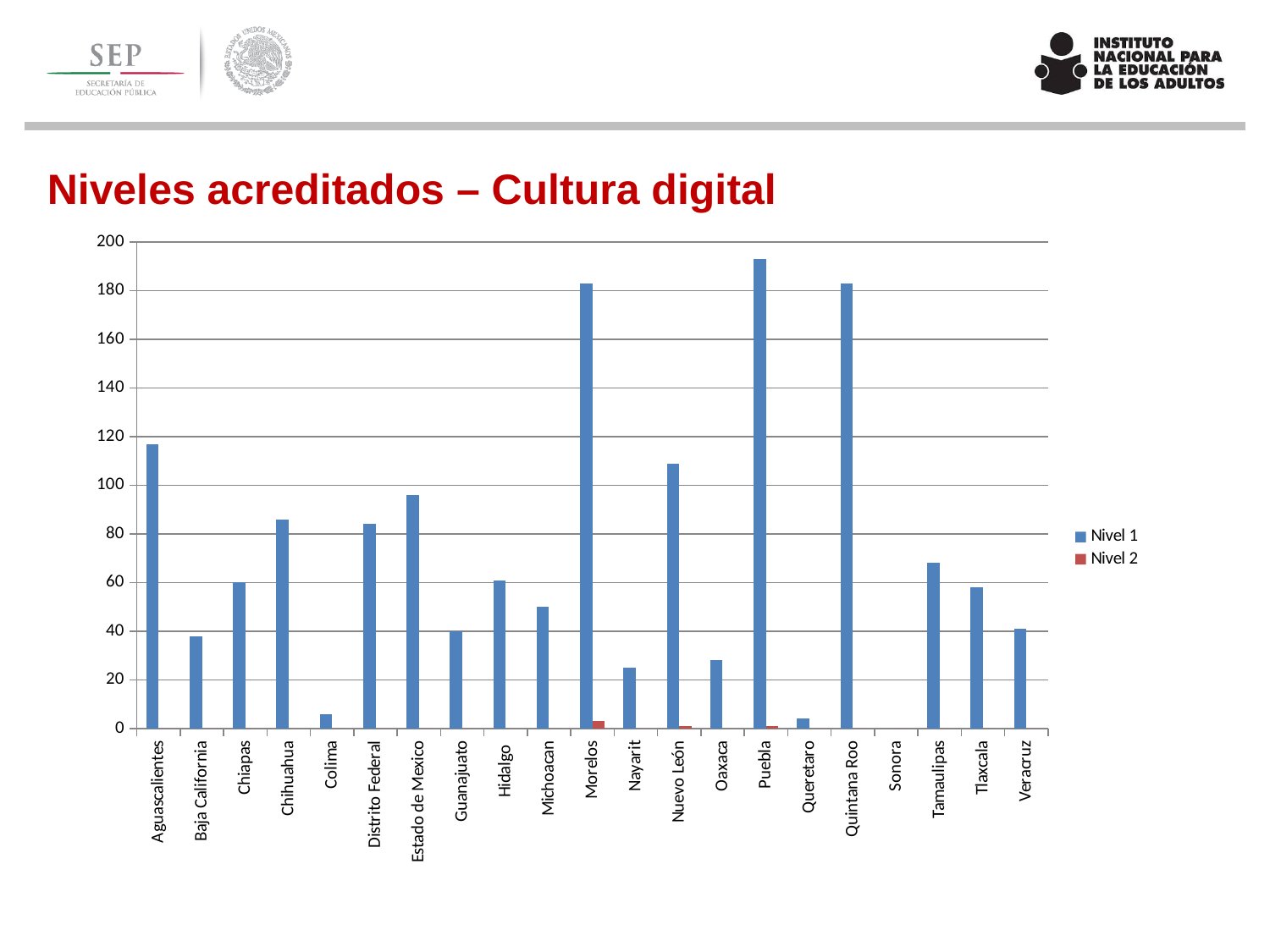
What is the title of the slide's chart? Niveles acreditados – Cultura digital Which state has the lowest Nivel 1 value? Sonora For how many states is a Nivel 2 bar visible? 3 How many states (categories) are shown on the x axis? 21 Which state has the highest Nivel 1 value? Puebla Is the Nivel 1 value for Chihuahua greater or less than 80? greater Which has the larger Nivel 1 value, Hidalgo or Michoacan? Hidalgo What kind of chart is shown on the slide? Bar chart Is the Nivel 1 value for Aguascalientes greater or less than 100? greater Is the Nivel 1 value for Nayarit greater or less than 40? less Which has the larger Nivel 1 value, Morelos or Nuevo León? Morelos How many series does the legend list? 2